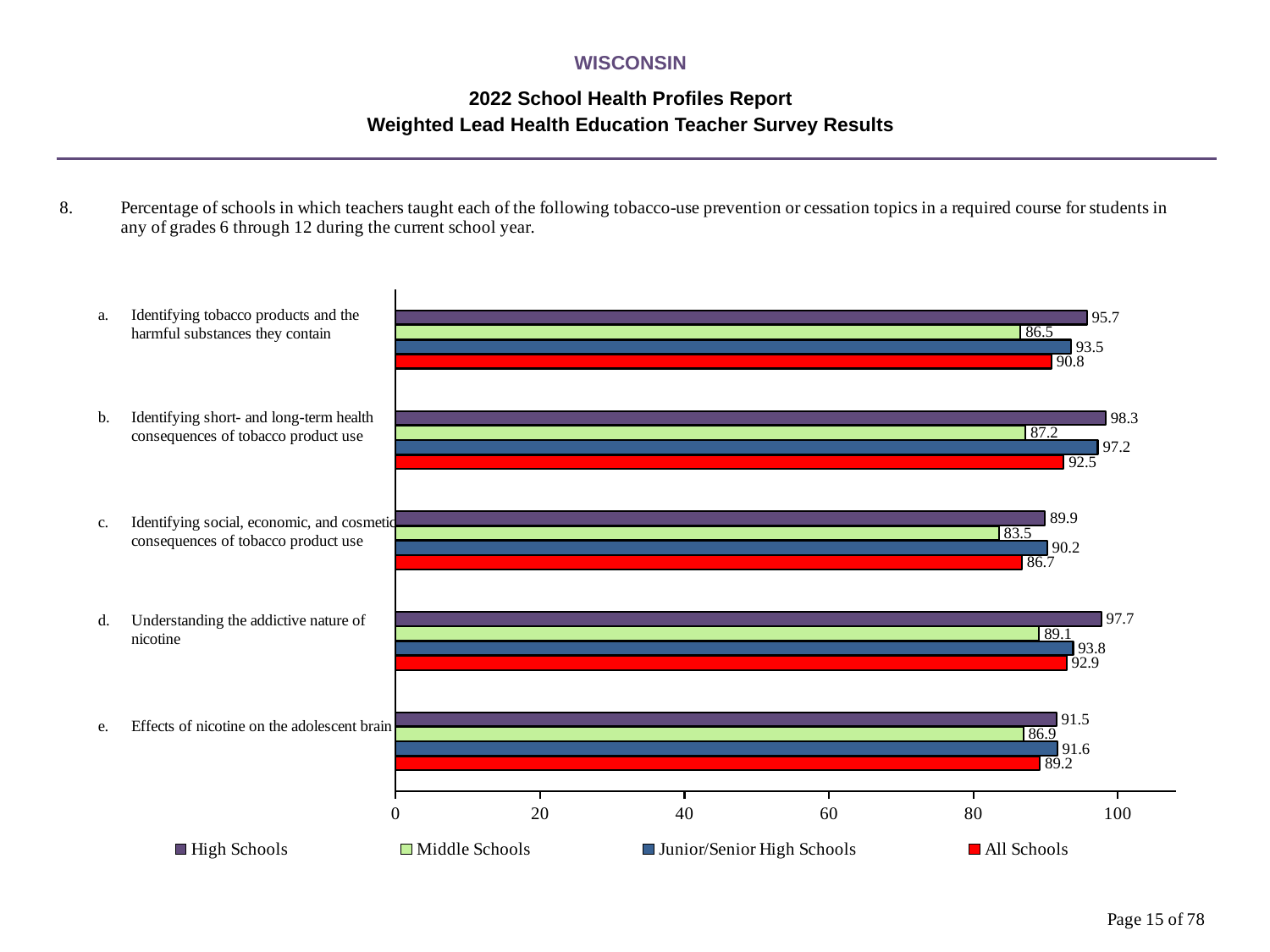
Is the Middle Schools value for topic b, identifying short- and long-term health consequences of tobacco product use, greater or less than 80? greater What is the value for Junior/Senior High Schools for topic e, effects of nicotine on the adolescent brain? 91.6 For topic a, identifying tobacco products and the harmful substances they contain, which is larger: the High Schools value or the Junior/Senior High Schools value? High Schools How many series does the legend list? 4 For topic a, identifying tobacco products and the harmful substances they contain, what is the difference between the High Schools value and the Middle Schools value? 9.2 What is the value for Middle Schools for topic c, identifying social, economic, and cosmetic consequences of tobacco product use? 83.5 Which topic has the lowest value for Middle Schools? c. Identifying social, economic, and cosmetic consequences of tobacco product use How many tobacco-use prevention topics are shown on the chart? 5 Which topic has the highest value for High Schools? b. Identifying short- and long-term health consequences of tobacco product use What kind of chart is shown on the slide? bar chart What is the value for All Schools for topic d, understanding the addictive nature of nicotine? 92.9 What is the value for High Schools for topic b, identifying short- and long-term health consequences of tobacco product use? 98.3